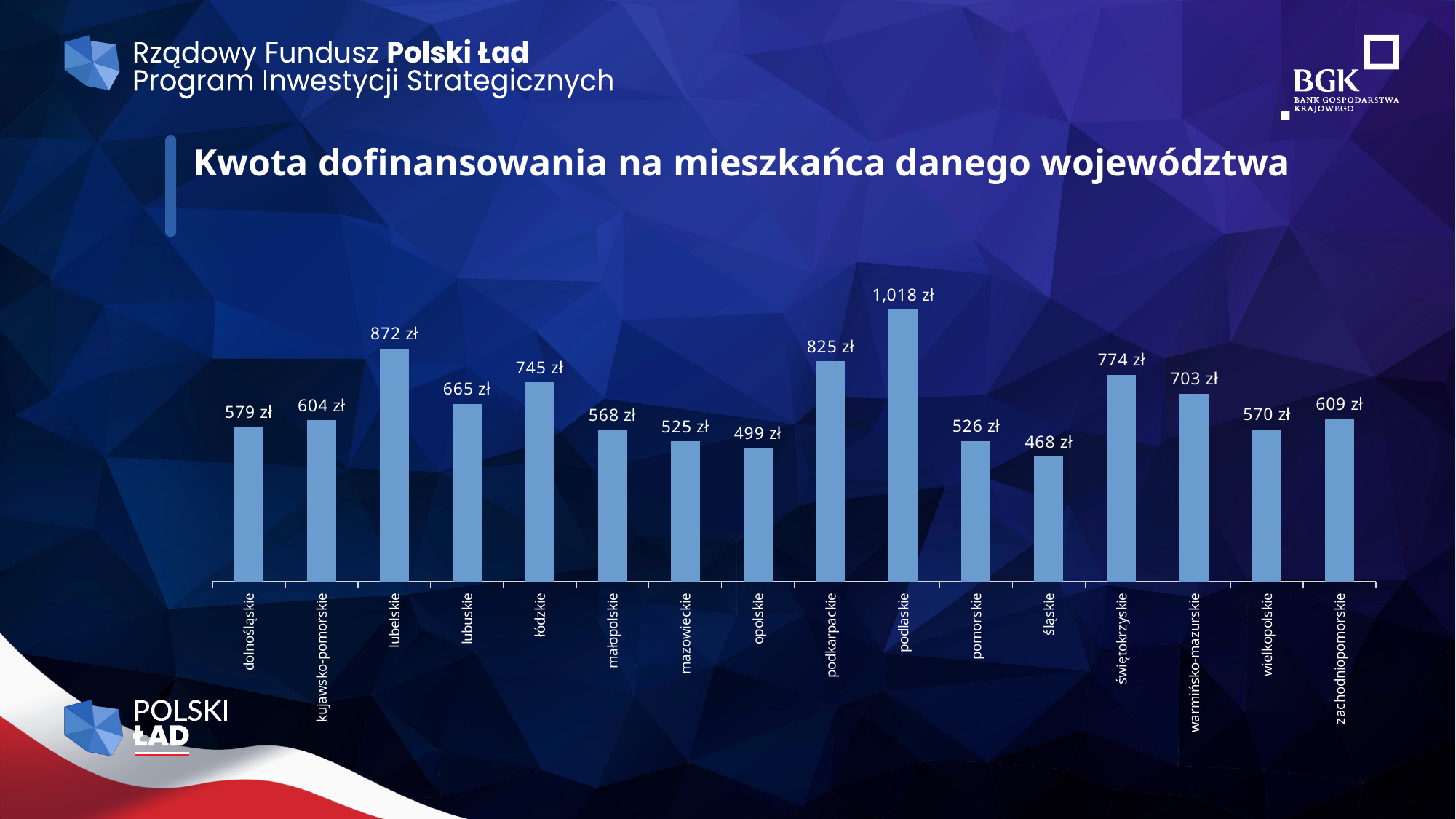
What is the value for mazowieckie? 525 zł What kind of chart is shown on the slide? bar chart What is the difference between the values for podlaskie and śląskie? 550 zł Which is larger, the value for świętokrzyskie or the value for lubuskie? świętokrzyskie What is the value for warmińsko-mazurskie? 703 zł Which voivodeship has the lowest value? śląskie How many voivodeships are shown on the chart? 16 What is the value for lubelskie? 872 zł Which voivodeship has the highest value? podlaskie What is the title of the chart? Kwota dofinansowania na mieszkańca danego województwa What is the difference between the values for podkarpackie and łódzkie? 80 zł Which is larger, the value for opolskie or the value for zachodniopomorskie? zachodniopomorskie